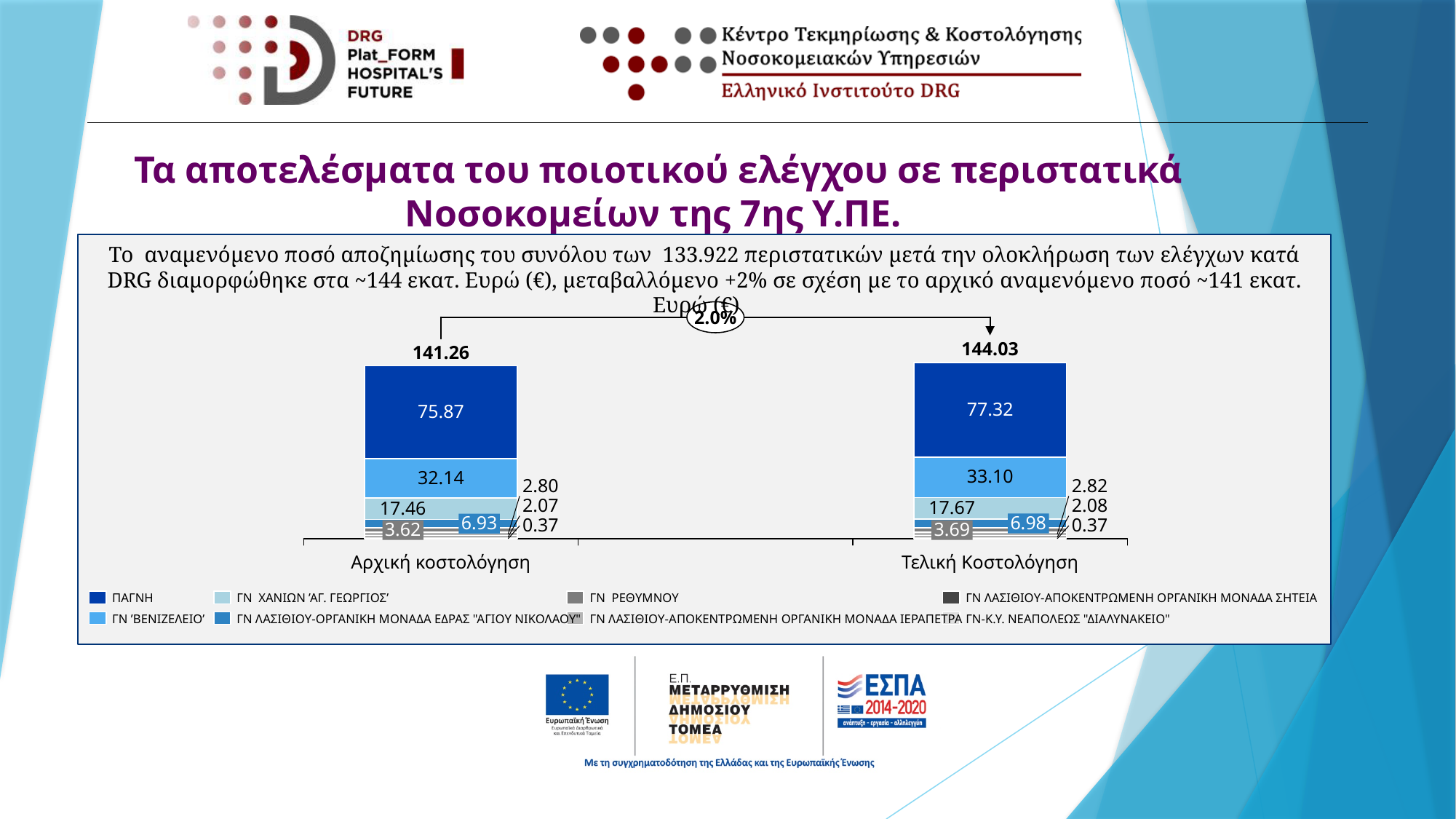
What is the value of the ΓΝ ΡΕΘΥΜΝΟΥ segment in the Αρχική κοστολόγηση bar? 3.62 Which hospital has the largest segment in the Αρχική κοστολόγηση bar? ΠΑΓΝΗ What is the total of the stacked bar for Αρχική κοστολόγηση? 141.26 What is the value of the ΠΑΓΝΗ segment in the Τελική Κοστολόγηση bar? 77.32 What is the value of the ΓΝ ΧΑΝΙΩΝ 'ΑΓ. ΓΕΩΡΓΙΟΣ' segment in the Τελική Κοστολόγηση bar? 17.67 What percentage change is shown between the Αρχική κοστολόγηση and Τελική Κοστολόγηση totals? 2.0% How many series does the chart legend list? 8 What is the value of the ΓΝ 'ΒΕΝΙΖΕΛΕΙΟ' segment in the Αρχική κοστολόγηση bar? 32.14 What type of chart is shown on the slide? Stacked bar chart What is the difference between the ΠΑΓΝΗ values in the Τελική Κοστολόγηση and Αρχική κοστολόγηση bars? 1.45 How many bars (categories) are plotted on the chart? 2 What is the total of the stacked bar for Τελική Κοστολόγηση? 144.03